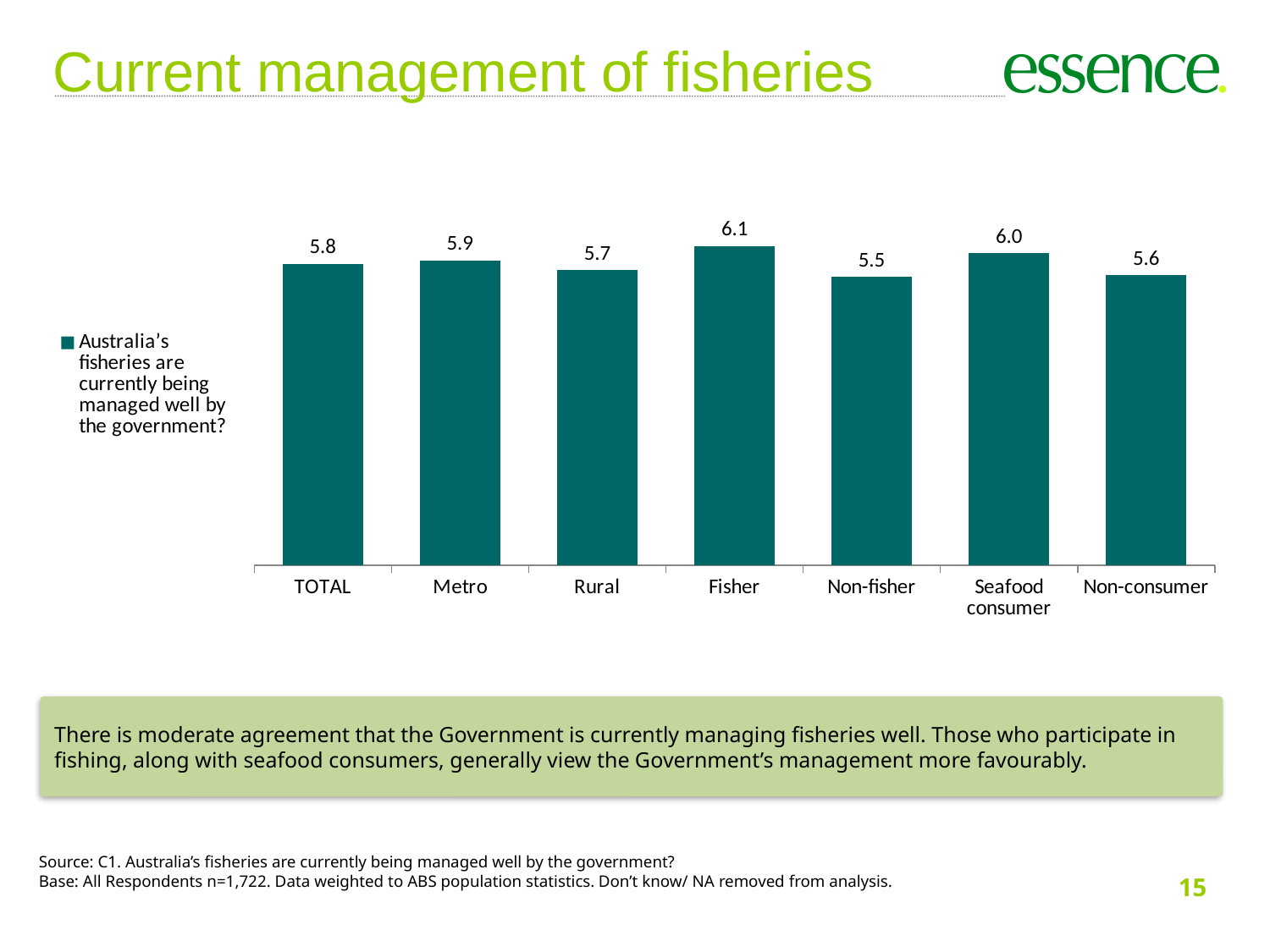
What is the difference between the values for Fisher and Non-fisher? 0.6 What kind of chart is shown on the slide? Bar chart Which category has the highest value? Fisher What is the value for Non-consumer? 5.6 What is the value for TOTAL? 5.8 What is the value for Fisher? 6.1 How many series does the legend list? 1 How many categories are shown on the x axis? 7 What is the value for Seafood consumer? 6.0 Which category has the lowest value? Non-fisher Which is larger, the value for Metro or the value for Rural? Metro What is the title of the slide? Current management of fisheries